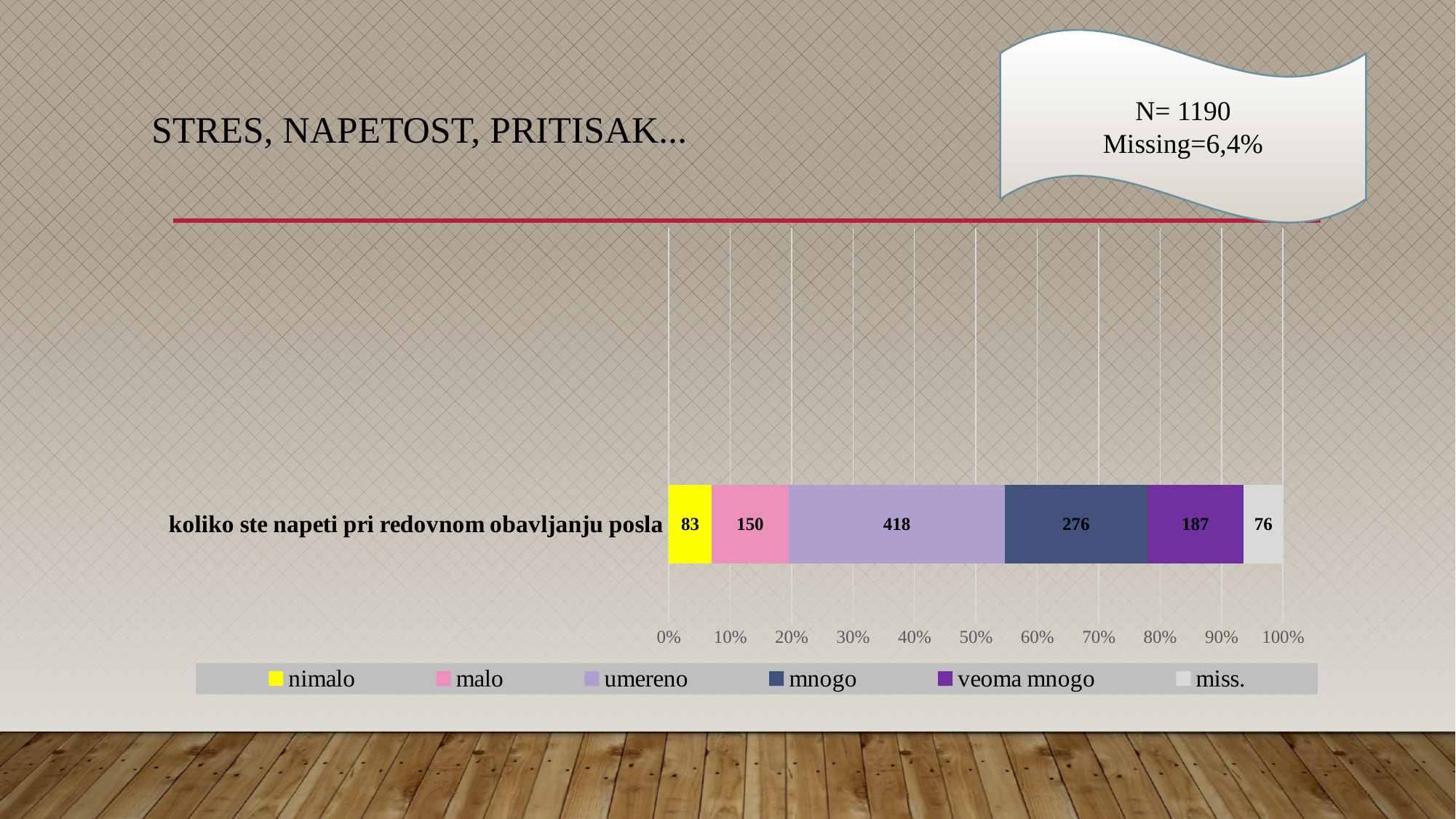
What value is shown for the "nimalo" segment of the bar? 83 What kind of chart is shown on the slide? Stacked bar chart Which series has the smallest value in the bar? miss. What value is shown for the "veoma mnogo" segment of the bar? 187 What is the total of all segments in the stacked bar? 1190 What value is shown for the "umereno" segment of the bar? 418 How many series does the legend list? 6 Which series has the largest value in the bar? umereno What is the difference between the "mnogo" and "malo" values? 126 What colour is the "nimalo" segment in the chart? Yellow Which is larger, the value for "mnogo" or the value for "veoma mnogo"? mnogo What value is shown for the "miss." segment of the bar? 76